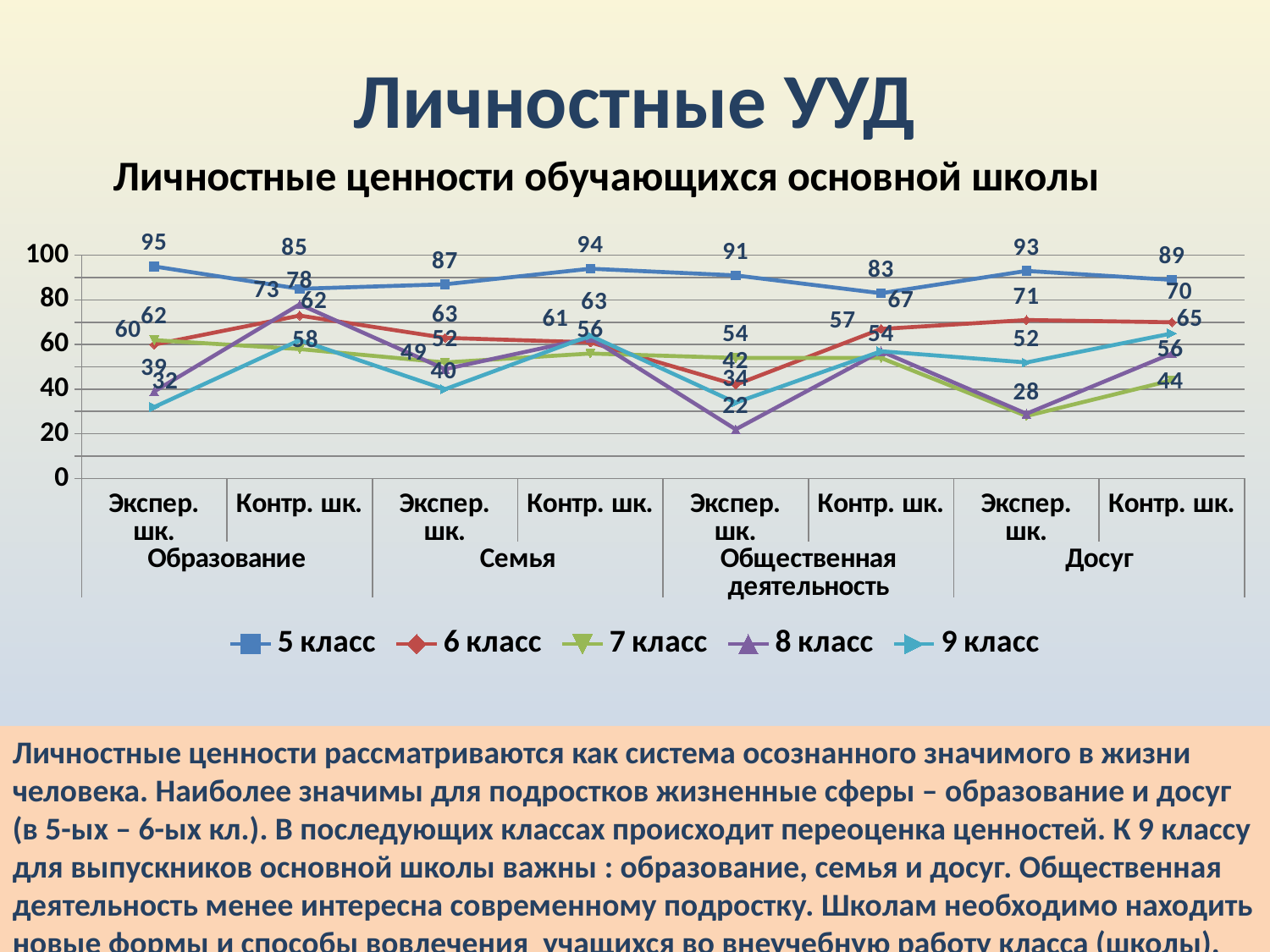
What is the value for 5 класс at Контр. шк. in the Общественная деятельность group? 83 Is the value for 8 класс at Экспер. шк. in the Общественная деятельность group greater or less than 40? less How many series does the legend list? 5 What kind of chart is shown on the slide? line chart At which category does 5 класс have its lowest value? Контр. шк., Общественная деятельность What is the value for 8 класс at Экспер. шк. in the Общественная деятельность group? 22 What is the difference between the 5 класс values at Экспер. шк. and Контр. шк. in the Образование group? 10 What is the value for 5 класс at Экспер. шк. in the Образование group? 95 How many data points are plotted along the x axis for each series? 8 What is the value for 7 класс at Контр. шк. in the Досуг group? 44 Which is larger at Экспер. шк. in the Общественная деятельность group: the value for 5 класс or for 8 класс? 5 класс At which category does 5 класс reach its highest value? Экспер. шк., Образование